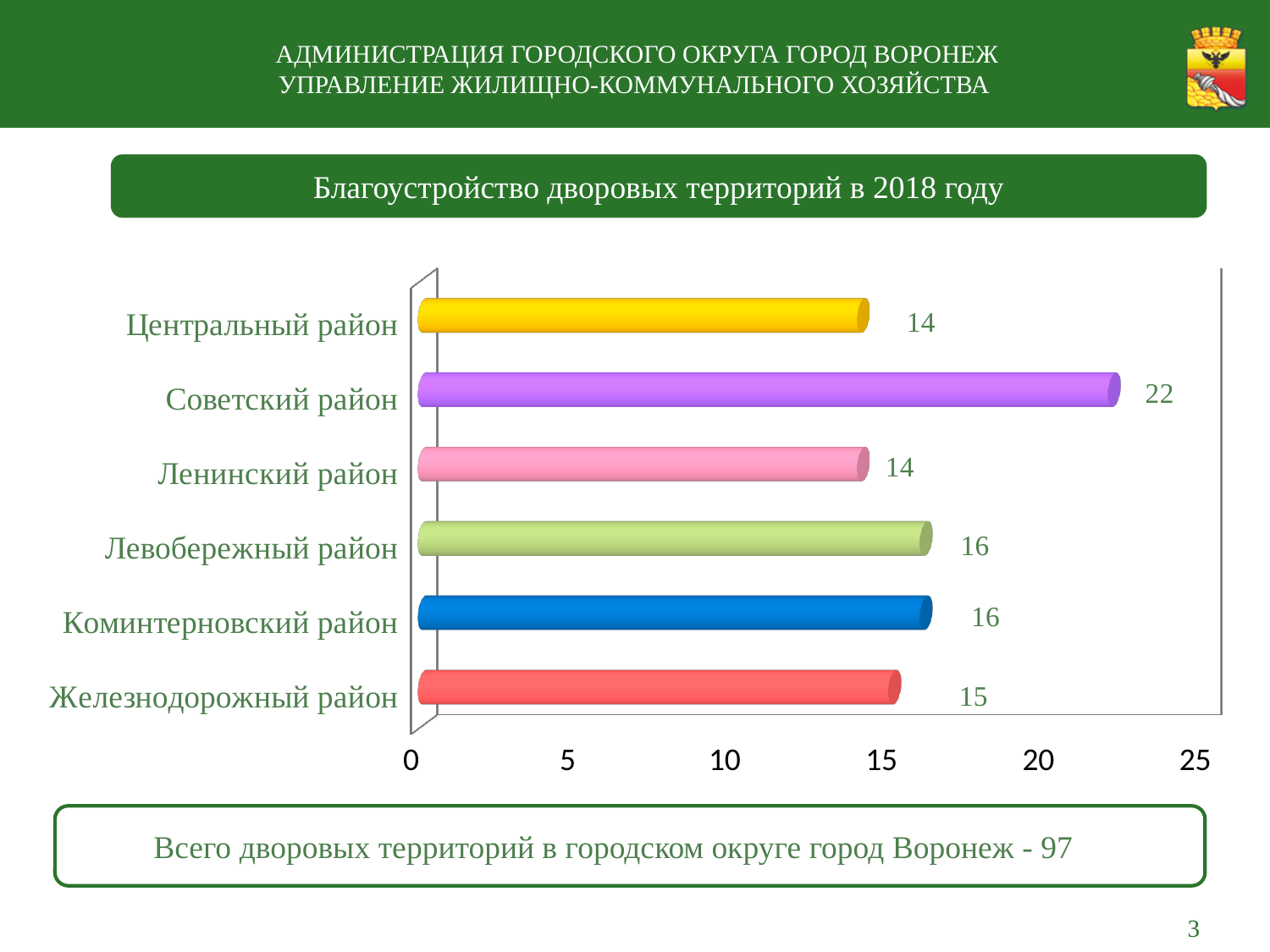
What colour is the bar for Коминтерновский район? blue Which district has the highest value? Советский район Which is larger, the value for Коминтерновский район or the value for Железнодорожный район? Коминтерновский район What is the difference between the values for Советский район and Центральный район? 8 What is the title of the chart? Благоустройство дворовых территорий в 2018 году What is the difference between the values for Левобережный район and Ленинский район? 2 Is the value for Советский район greater or less than 20? greater What kind of chart is shown on the slide? bar chart What is the value for Железнодорожный район? 15 What is the value for Левобережный район? 16 How many districts are shown in the chart? 6 What is the value for Советский район? 22